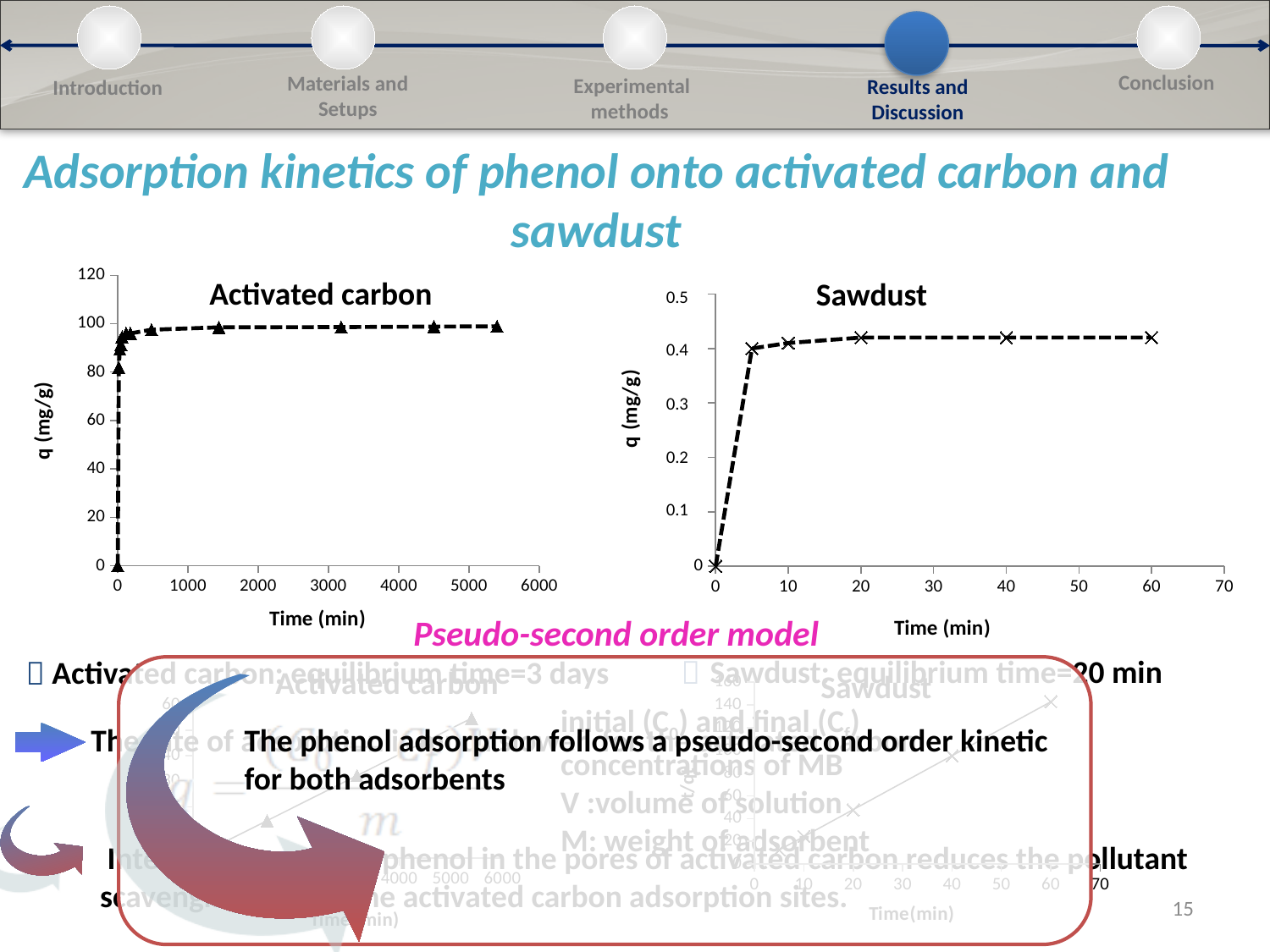
In the Sawdust chart, is the value at 60 min greater or less than 0.4? greater In the Sawdust chart, at which time is the value lowest? 0 min In the Activated carbon chart, do the values rise or fall as time increases from 0 to about 5400 min? rise In the Sawdust chart, do the values rise or fall as time increases from 0 to 60 min? rise In the Sawdust chart, what is the value at time 0? 0 In the Activated carbon chart, is the value at about 5400 min greater or less than 80? greater What is the y-axis label of the Activated carbon chart? q (mg/g) What kind of chart is the Sawdust chart? line chart How many data points are plotted in the Sawdust chart? 6 In the Sawdust chart, is the value at 5 min greater or less than 0.3? greater What kind of chart is the Activated carbon chart? line chart